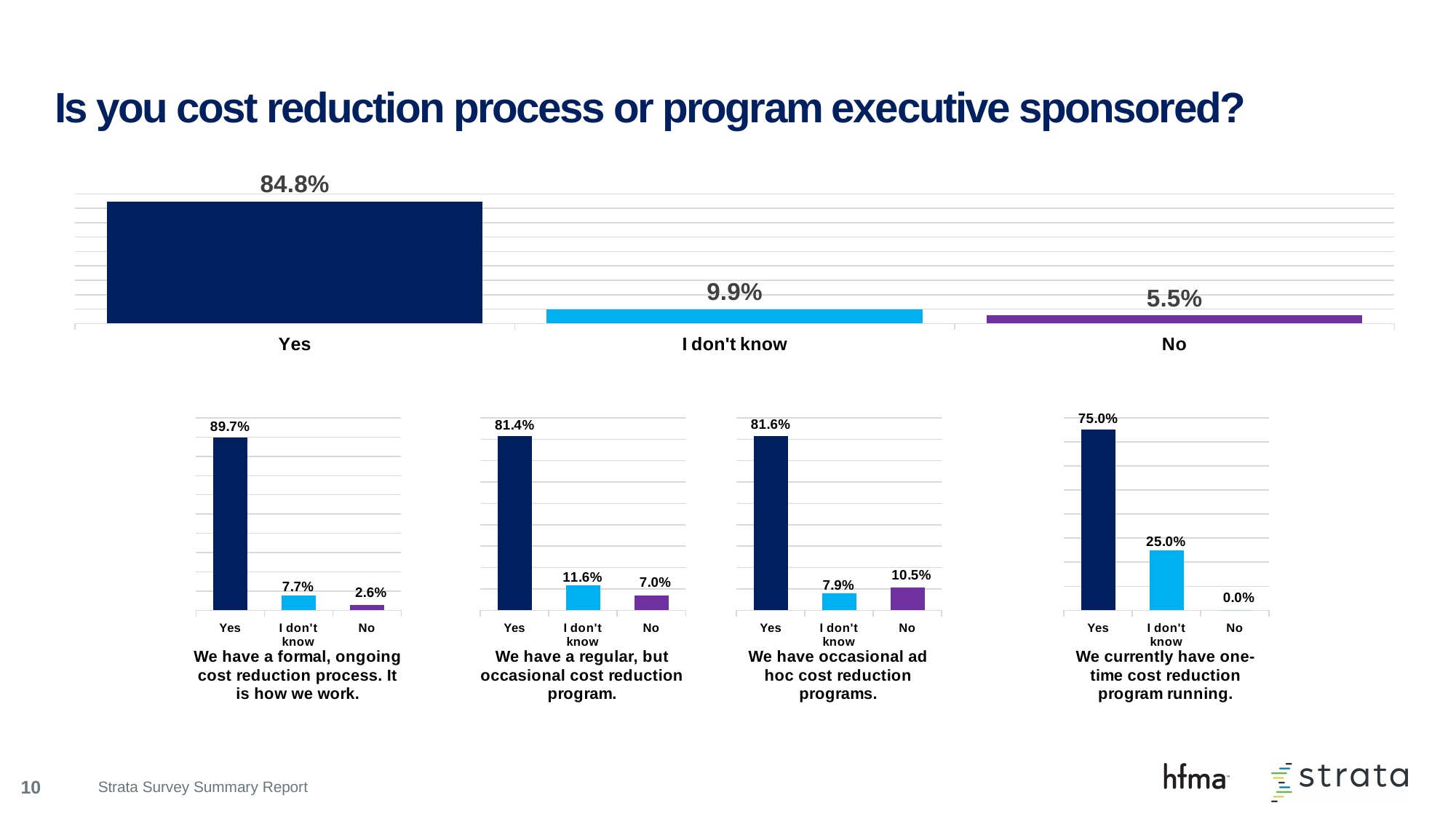
In the top chart, what is the difference between the values for "Yes" and "No"? 79.3% In the top chart, which category has the lowest value? No How many small charts are shown in the bottom row of the slide? 4 In the chart titled "We have a regular, but occasional cost reduction program.", what is the value for "I don't know"? 11.6% What kind of chart is the top chart? bar chart In the chart titled "We currently have one-time cost reduction program running.", what is the difference between the values for "Yes" and "I don't know"? 50.0% In the chart titled "We have occasional ad hoc cost reduction programs.", which is larger, "I don't know" or "No"? No In the top chart, how many categories are shown? 3 In the top chart, what is the value for "I don't know"? 9.9% In the chart titled "We have a formal, ongoing cost reduction process. It is how we work.", what is the value for "Yes"? 89.7% In the chart titled "We currently have one-time cost reduction program running.", what is the value for "No"? 0.0% In the top chart, what is the value for "Yes"? 84.8%